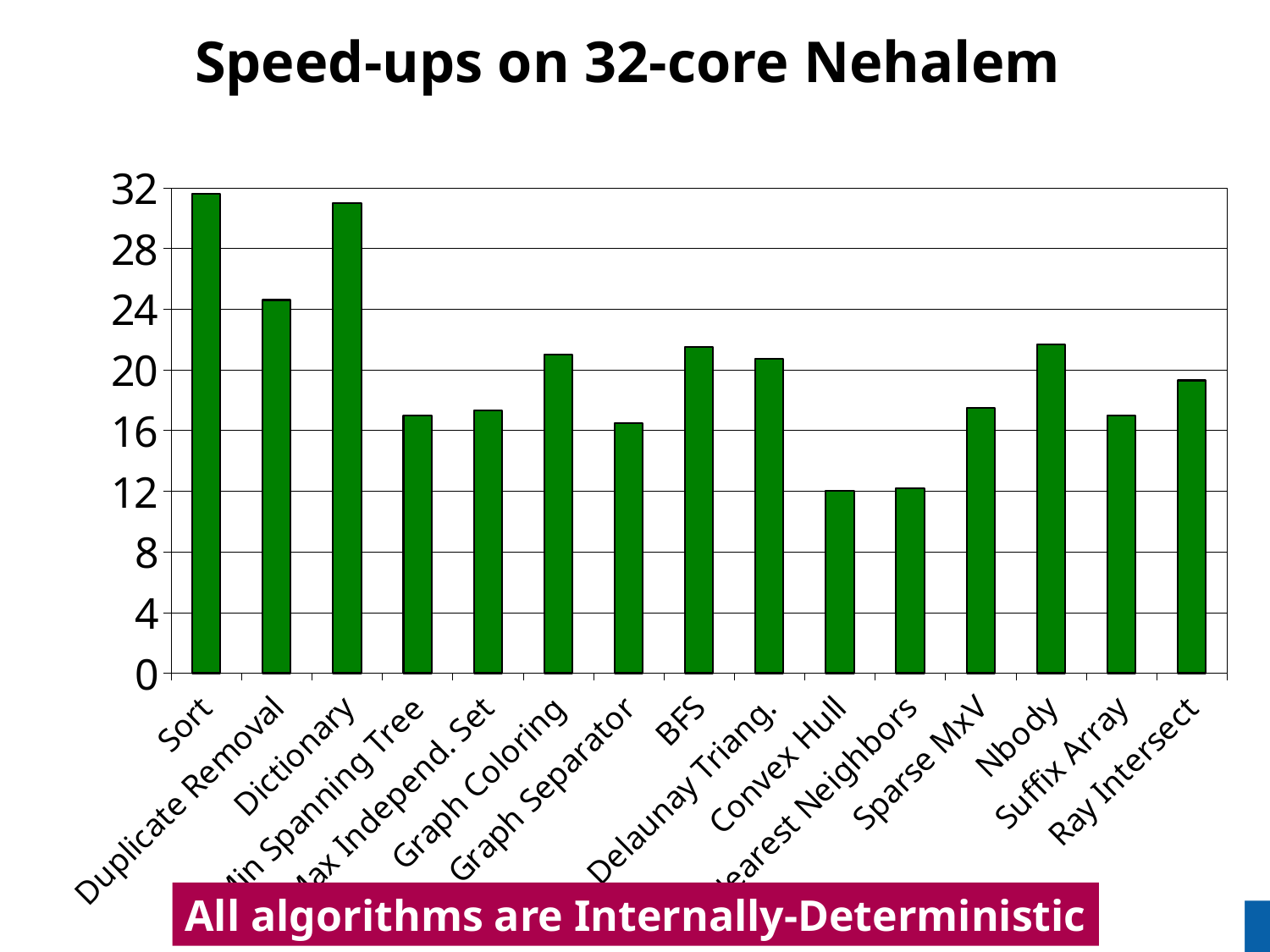
Is the speed-up for Sort greater or less than 28? greater How many algorithms (categories) are plotted in the chart? 15 What is the title of the chart? Speed-ups on 32-core Nehalem What colour are the bars in the chart? green Which has the larger speed-up, Dictionary or Duplicate Removal? Dictionary Which algorithm has the highest speed-up in the chart? Sort Is the speed-up for Duplicate Removal greater or less than 28? less Is the speed-up for Nbody greater or less than 20? greater Which has the larger speed-up, BFS or Convex Hull? BFS What kind of chart is shown on the slide? bar chart